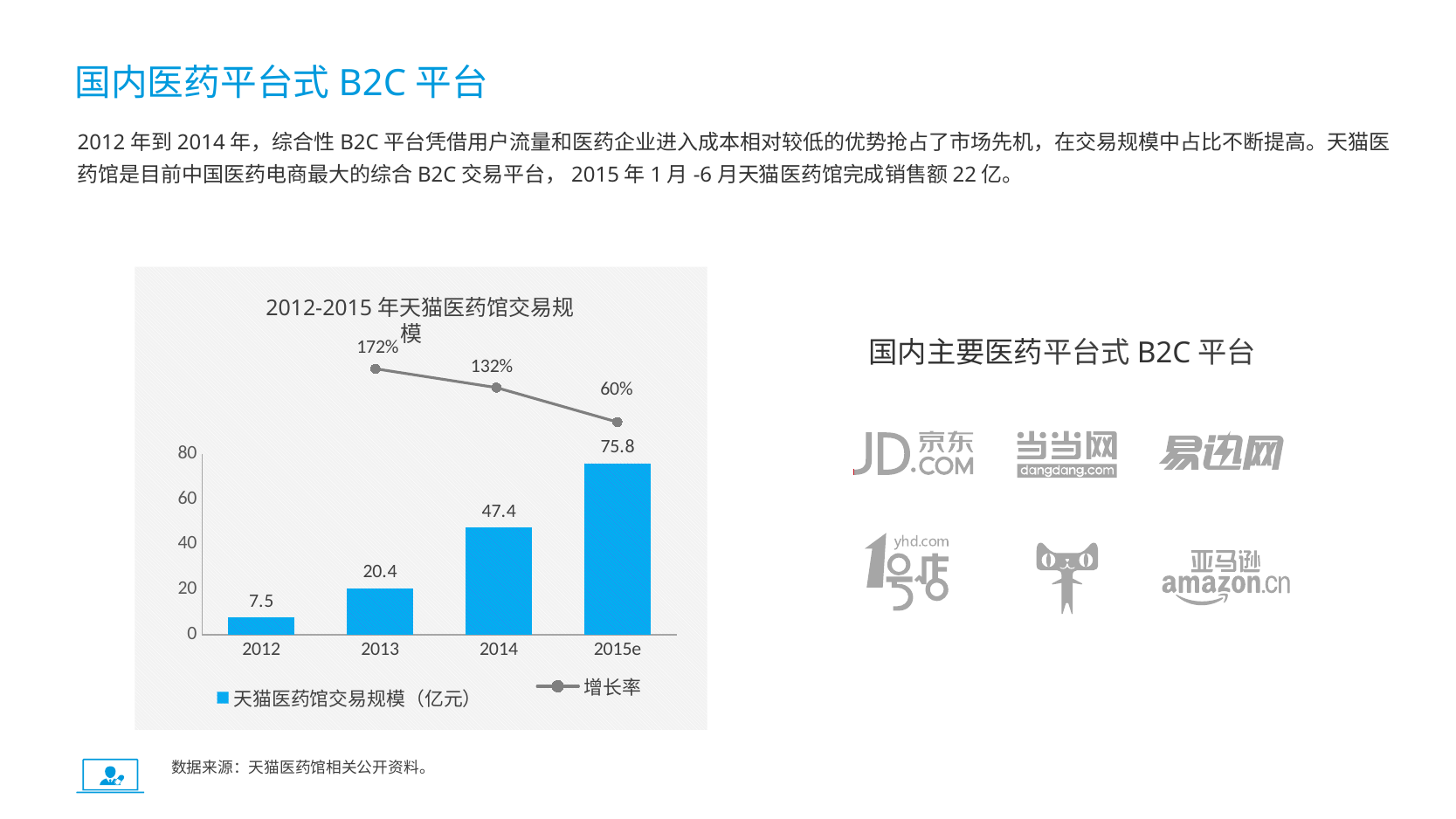
Which is larger, the 天猫医药馆交易规模 for 2013 or for 2012? 2013 What kind of chart is this? Combined bar and line chart Does the 增长率 rise or fall from 2013 to 2015e? Fall Which year has the highest 天猫医药馆交易规模 (亿元)? 2015e What is the 增长率 value for 2015e? 60% What is the 天猫医药馆交易规模 (亿元) value for 2014? 47.4 What is the difference in 天猫医药馆交易规模 (亿元) between 2015e and 2014? 28.4 How many series does the legend list? 2 What is the 增长率 value for 2013? 172% How many years are shown on the x axis? 4 What is the 天猫医药馆交易规模 (亿元) value for 2012? 7.5 Which year has the lowest 增长率 among those shown? 2015e